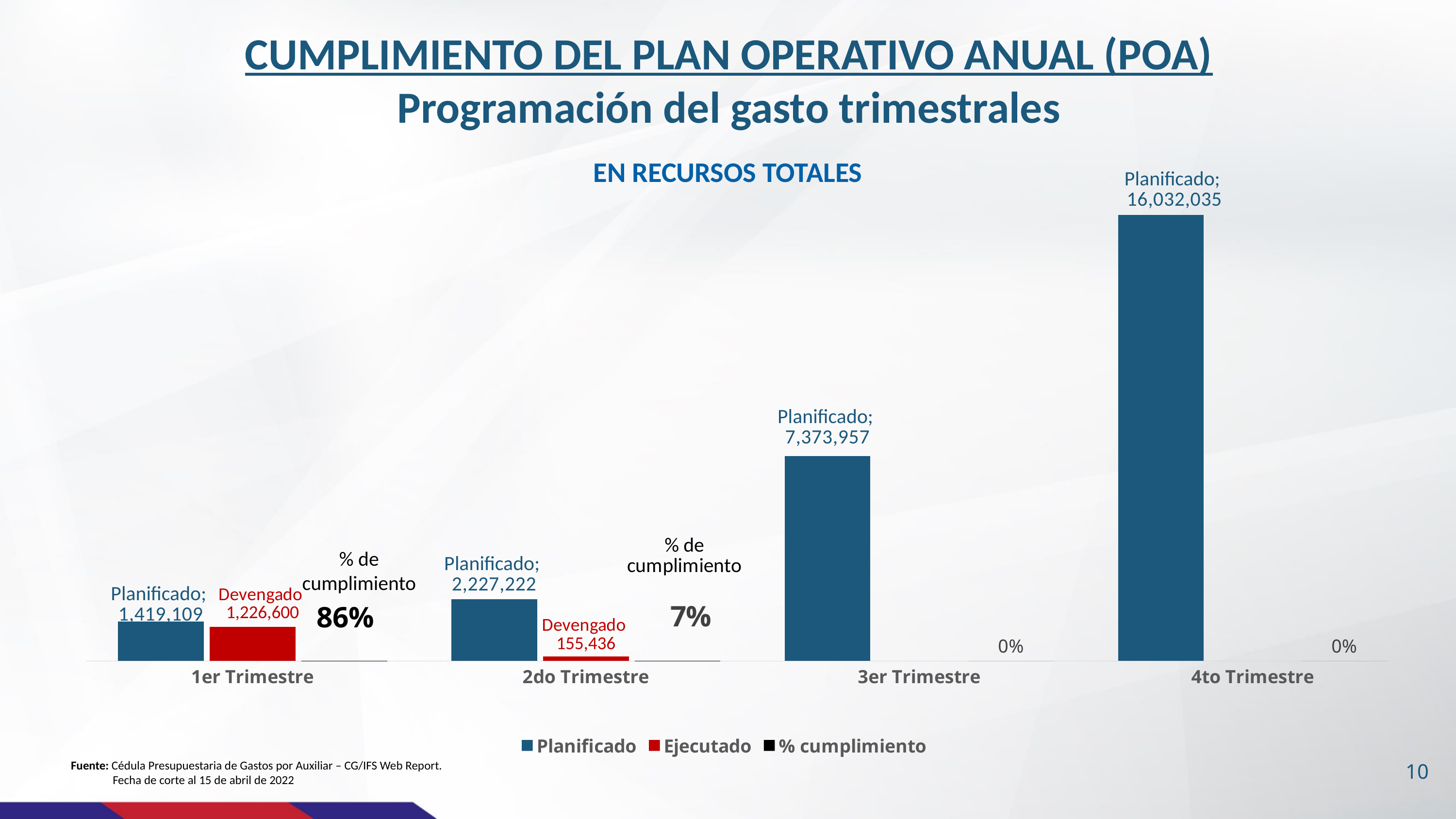
How many series does the legend list? 3 What kind of chart is shown on the slide? Bar chart Which quarter has the highest Planificado value? 4to Trimestre What is the % de cumplimiento for 2do Trimestre? 7% Which is larger, the Planificado value for 3er Trimestre or for 2do Trimestre? 3er Trimestre How many quarters are shown on the x axis? 4 What is the difference between the Planificado and Devengado values for 2do Trimestre? 2,071,786 What is the Planificado value for 2do Trimestre? 2,227,222 Which quarter has the lowest Planificado value? 1er Trimestre What is the Planificado value for 4to Trimestre? 16,032,035 Do the Planificado values rise or fall from 1er Trimestre to 4to Trimestre? Rise What is the Devengado value for 1er Trimestre? 1,226,600